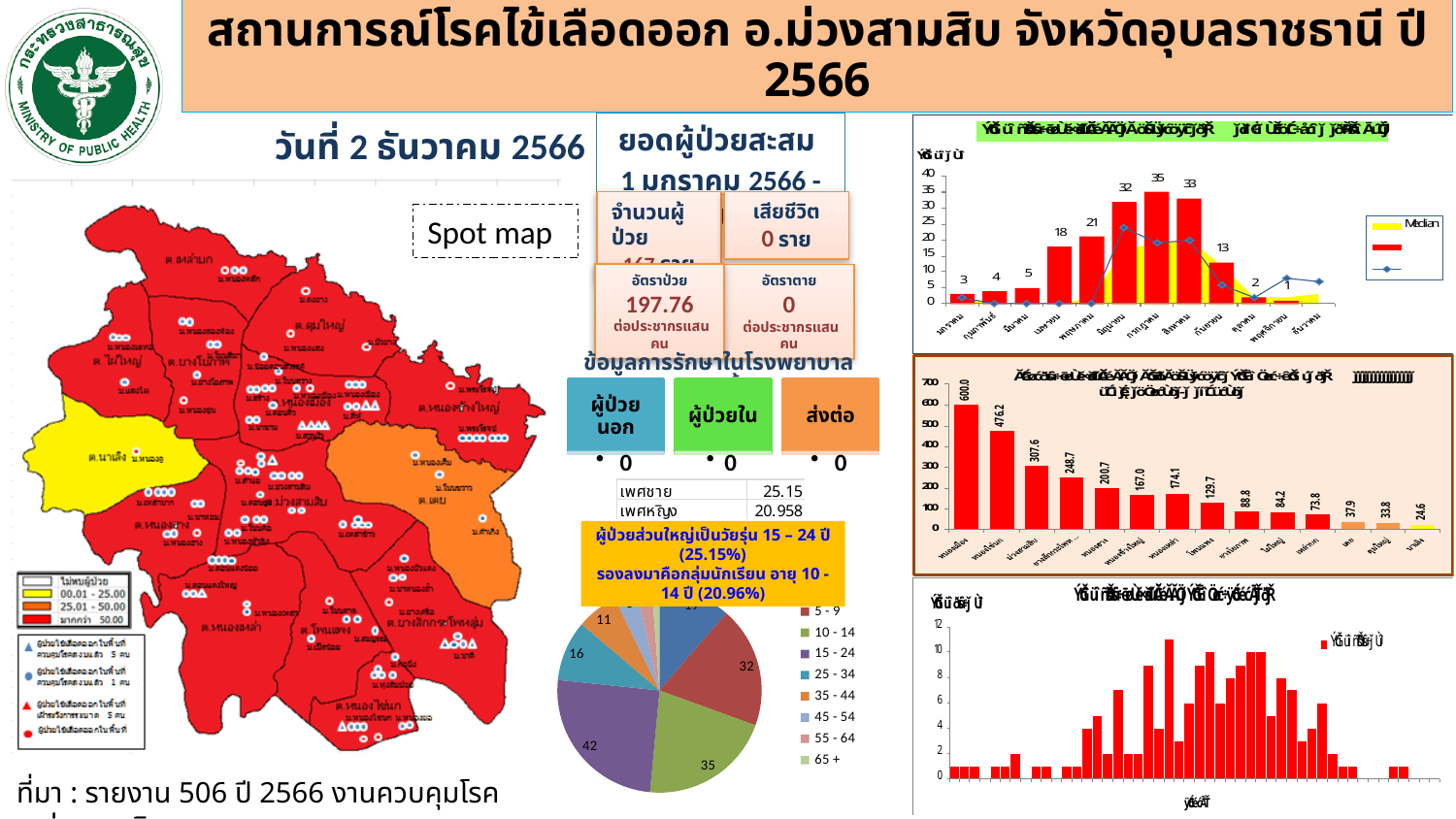
What kind of chart is the bottom-right chart? bar chart In the top-right monthly bar chart, what is the value for กรกฎาคม? 35 In the pie chart of age groups, what is the value of the largest slice? 42 In the top-right monthly bar chart, do the values rise or fall from มกราคม to กรกฎาคม? rise In the pie chart of age groups, what is the value for the 10 - 14 group? 35 In the middle-right bar chart, what is the highest value shown? 600.0 In the middle-right bar chart, what is the lowest value shown? 24.6 In the top-right monthly bar chart, what is the difference between the values for กรกฎาคม and สิงหาคม? 2 In the middle-right bar chart, how many bars are plotted? 14 In the top-right monthly bar chart, how many entries does the legend list? 3 In the top-right monthly bar chart, what is the value for มกราคม? 3 In the top-right monthly bar chart, which month has the highest value? กรกฎาคม